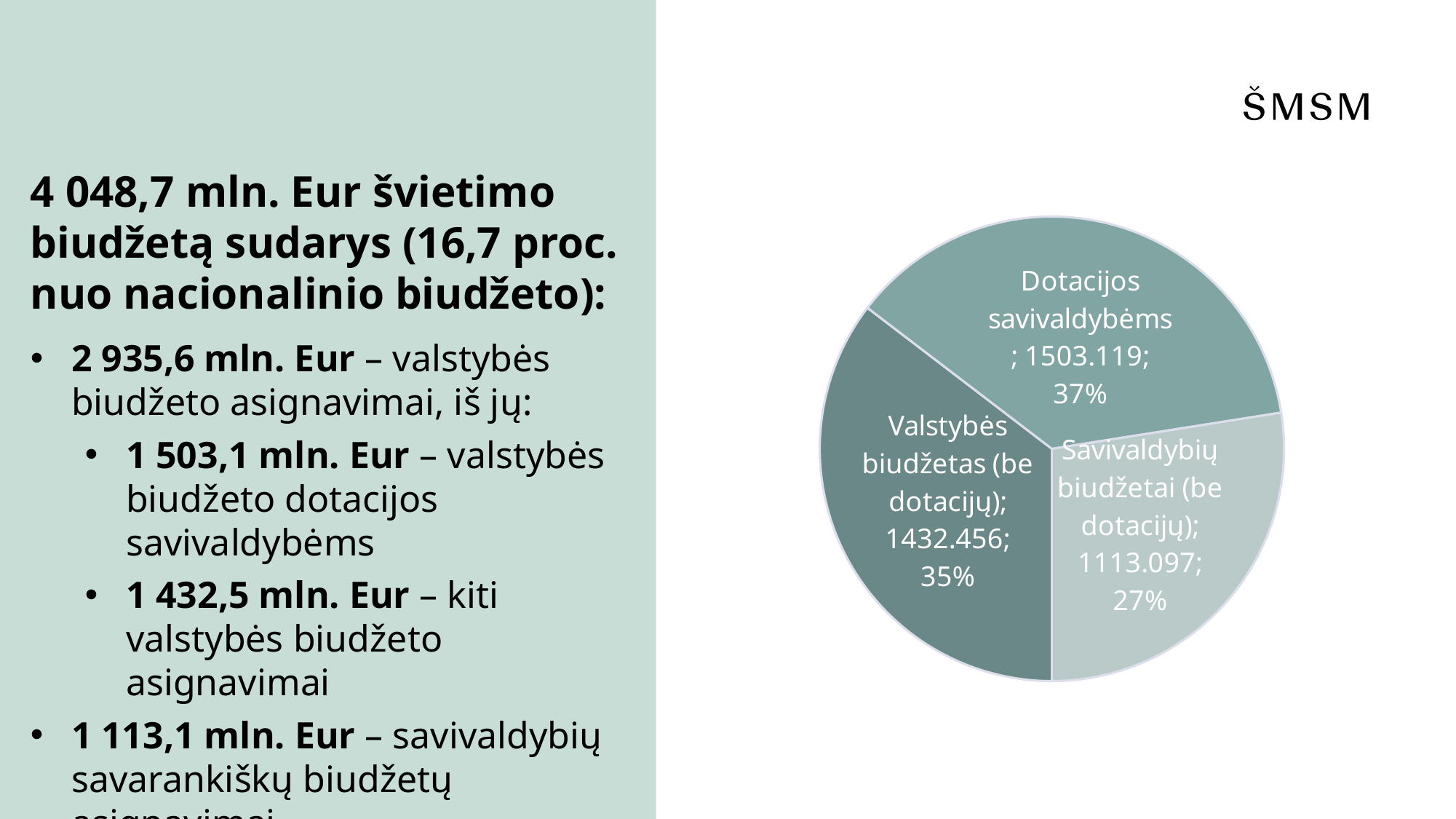
What percentage share of the pie does "Valstybės biudžetas (be dotacijų)" have? 35% What kind of chart is shown on the slide? pie chart Which slice of the pie chart is the largest? Dotacijos savivaldybėms What percentage share of the pie does "Dotacijos savivaldybėms" have? 37% How many slices does the pie chart have? 3 What is the value shown for the "Valstybės biudžetas (be dotacijų)" slice? 1432.456 What is the value shown for the "Savivaldybių biudžetai (be dotacijų)" slice? 1113.097 Which is larger: the "Valstybės biudžetas (be dotacijų)" slice or the "Savivaldybių biudžetai (be dotacijų)" slice? Valstybės biudžetas (be dotacijų) What percentage share of the pie does "Savivaldybių biudžetai (be dotacijų)" have? 27% Which slice of the pie chart is the smallest? Savivaldybių biudžetai (be dotacijų) What is the value shown for the "Dotacijos savivaldybėms" slice? 1503.119 What is the difference in percentage points between the "Dotacijos savivaldybėms" share and the "Savivaldybių biudžetai (be dotacijų)" share? 10 percentage points